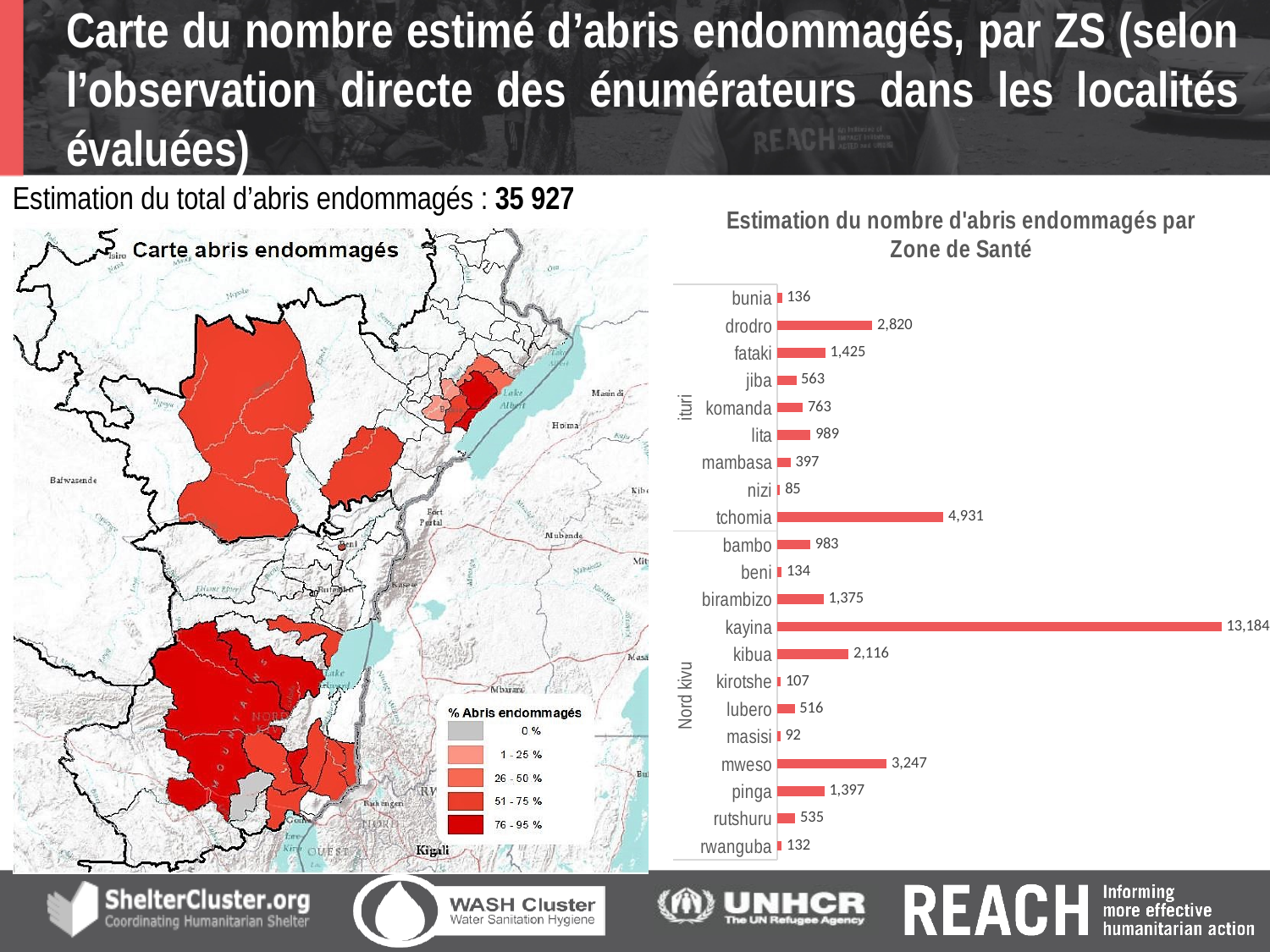
What kind of chart is 'Estimation du nombre d'abris endommagés par Zone de Santé'? bar chart In the bar chart 'Estimation du nombre d'abris endommagés par Zone de Santé', what is the difference between the values for mweso and drodro? 427 In the bar chart 'Estimation du nombre d'abris endommagés par Zone de Santé', which is larger, the value for drodro or the value for kibua? drodro In the bar chart 'Estimation du nombre d'abris endommagés par Zone de Santé', what is the value for kayina? 13,184 How many zones de santé are shown in the bar chart 'Estimation du nombre d'abris endommagés par Zone de Santé'? 21 In the bar chart 'Estimation du nombre d'abris endommagés par Zone de Santé', what is the difference between the values for kayina and tchomia? 8,253 In the bar chart 'Estimation du nombre d'abris endommagés par Zone de Santé', what is the value for nizi? 85 In the bar chart 'Estimation du nombre d'abris endommagés par Zone de Santé', what is the value for mweso? 3,247 In the bar chart 'Estimation du nombre d'abris endommagés par Zone de Santé', which zone de santé has the lowest value? nizi In the bar chart 'Estimation du nombre d'abris endommagés par Zone de Santé', which zone de santé has the highest value? kayina In the bar chart 'Estimation du nombre d'abris endommagés par Zone de Santé', what is the value for tchomia? 4,931 In the bar chart 'Estimation du nombre d'abris endommagés par Zone de Santé', which two provinces group the zones de santé on the axis? Ituri and Nord Kivu